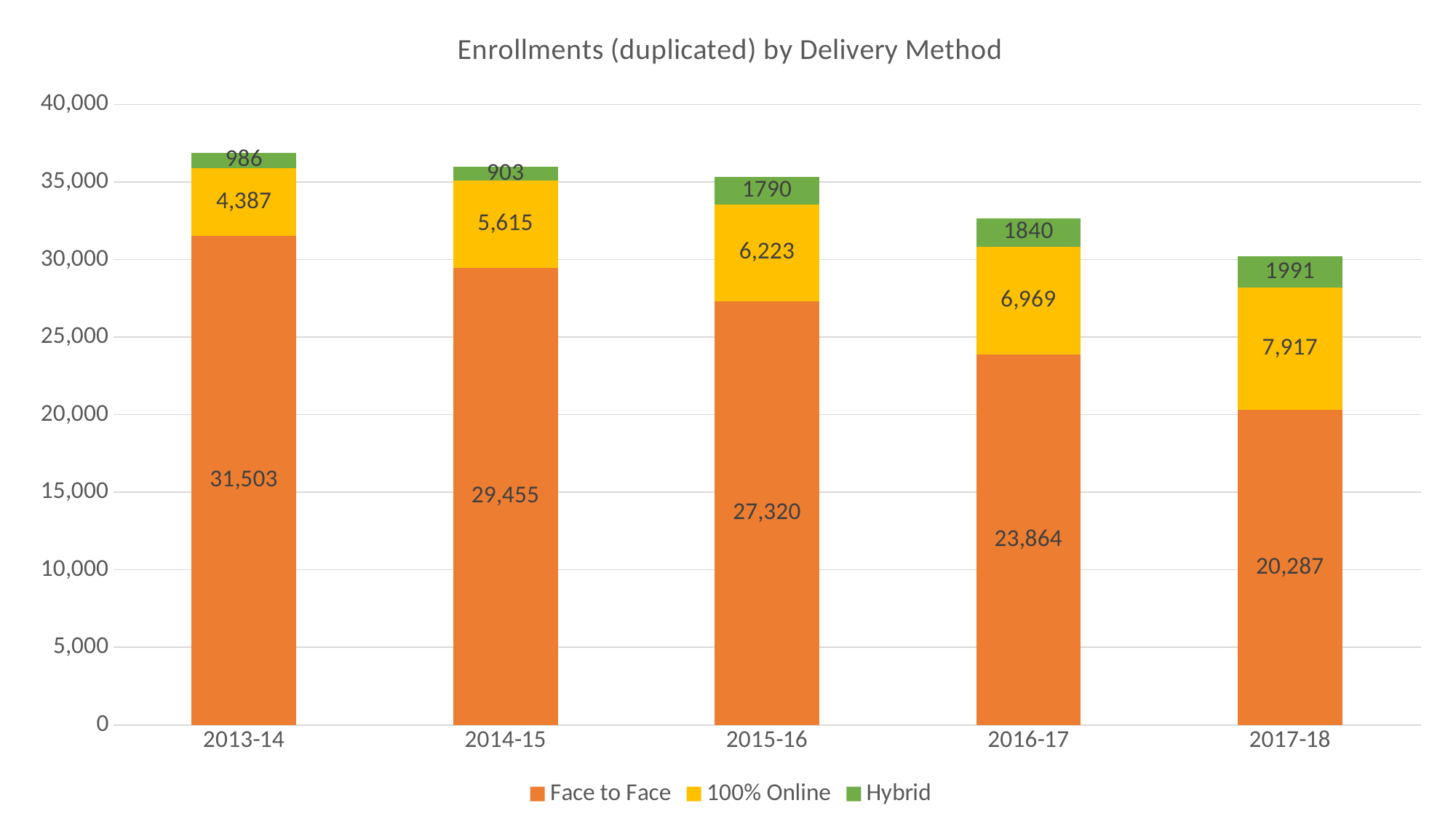
What is the total enrollment for the 2017-18 stacked bar? 30,195 How many series does the legend list? 3 What kind of chart is shown on the slide? Stacked bar chart Which year has the highest Face to Face enrollment? 2013-14 Do the Face to Face enrollments rise or fall from 2013-14 to 2017-18? Fall What is the Face to Face enrollment value for 2015-16? 27,320 What is the Hybrid enrollment value for 2014-15? 903 What is the difference between the Face to Face enrollment in 2013-14 and in 2017-18? 11,216 Which year has the lowest Hybrid enrollment? 2014-15 How many years are shown on the x axis? 5 What is the 100% Online enrollment value for 2017-18? 7,917 Which is larger, the 100% Online enrollment in 2016-17 or in 2015-16? 2016-17